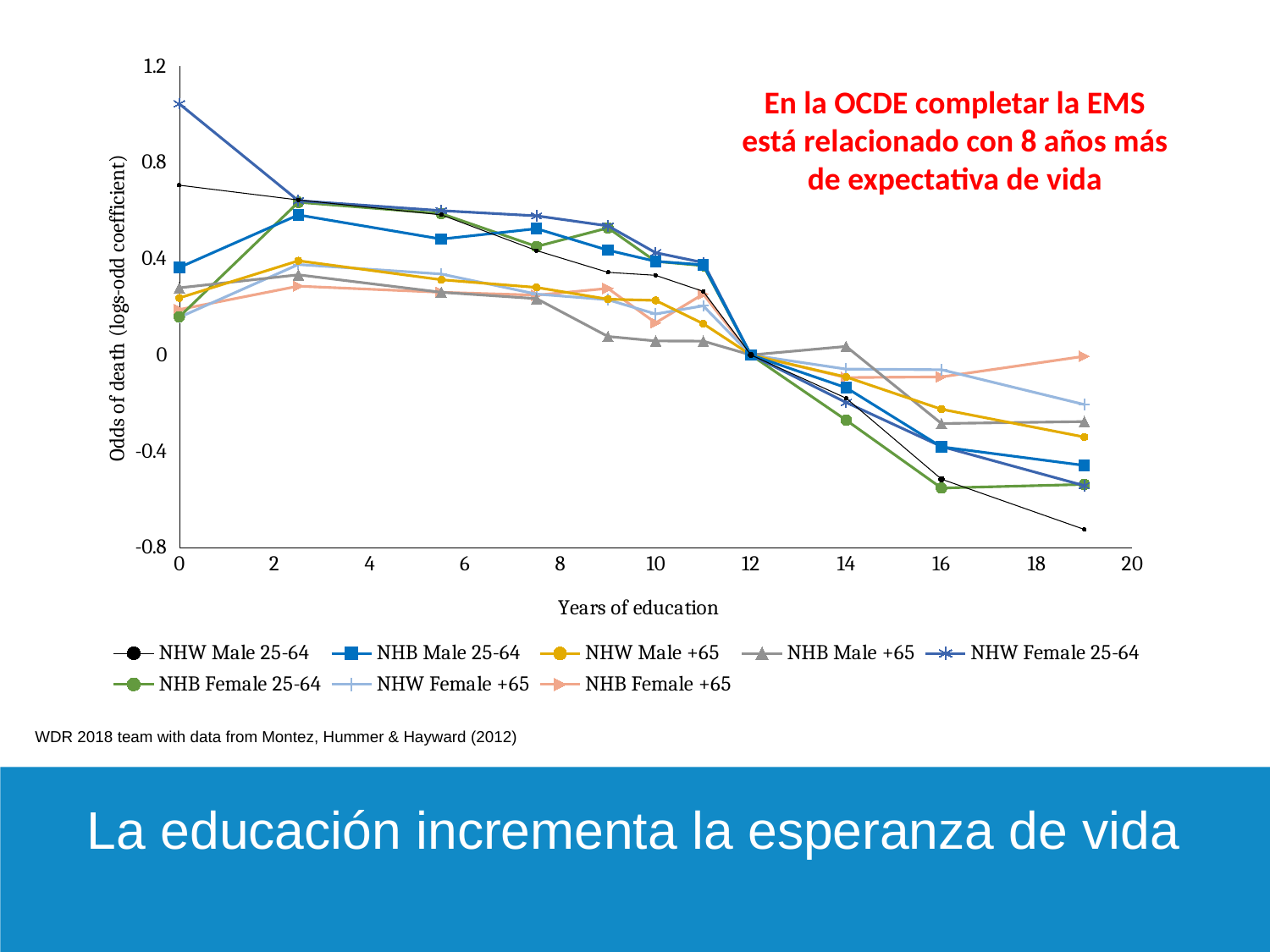
Which series has the highest value at 0 years of education? NHW Female 25-64 At 0 years of education, which is larger: the value for NHW Female 25-64 or for NHB Female 25-64? NHW Female 25-64 At 19 years of education, which is larger: the value for NHB Female +65 or for NHW Male 25-64? NHB Female +65 What is the value of the NHW Female 25-64 series at 12 years of education? 0 Do the values of the NHB Male 25-64 series generally rise or fall as years of education increase? fall What is the label of the vertical axis? Odds of death (logs-odd coefficient) Is the value for NHW Male +65 at 19 years of education greater or less than 0? less Is the value for NHW Male 25-64 at 19 years of education greater or less than -0.4? less How many series does the legend list? 8 Is the value for NHW Female 25-64 at 0 years of education greater or less than 0.8? greater What kind of chart is shown on the slide? line chart Which series has the lowest value at 19 years of education? NHW Male 25-64